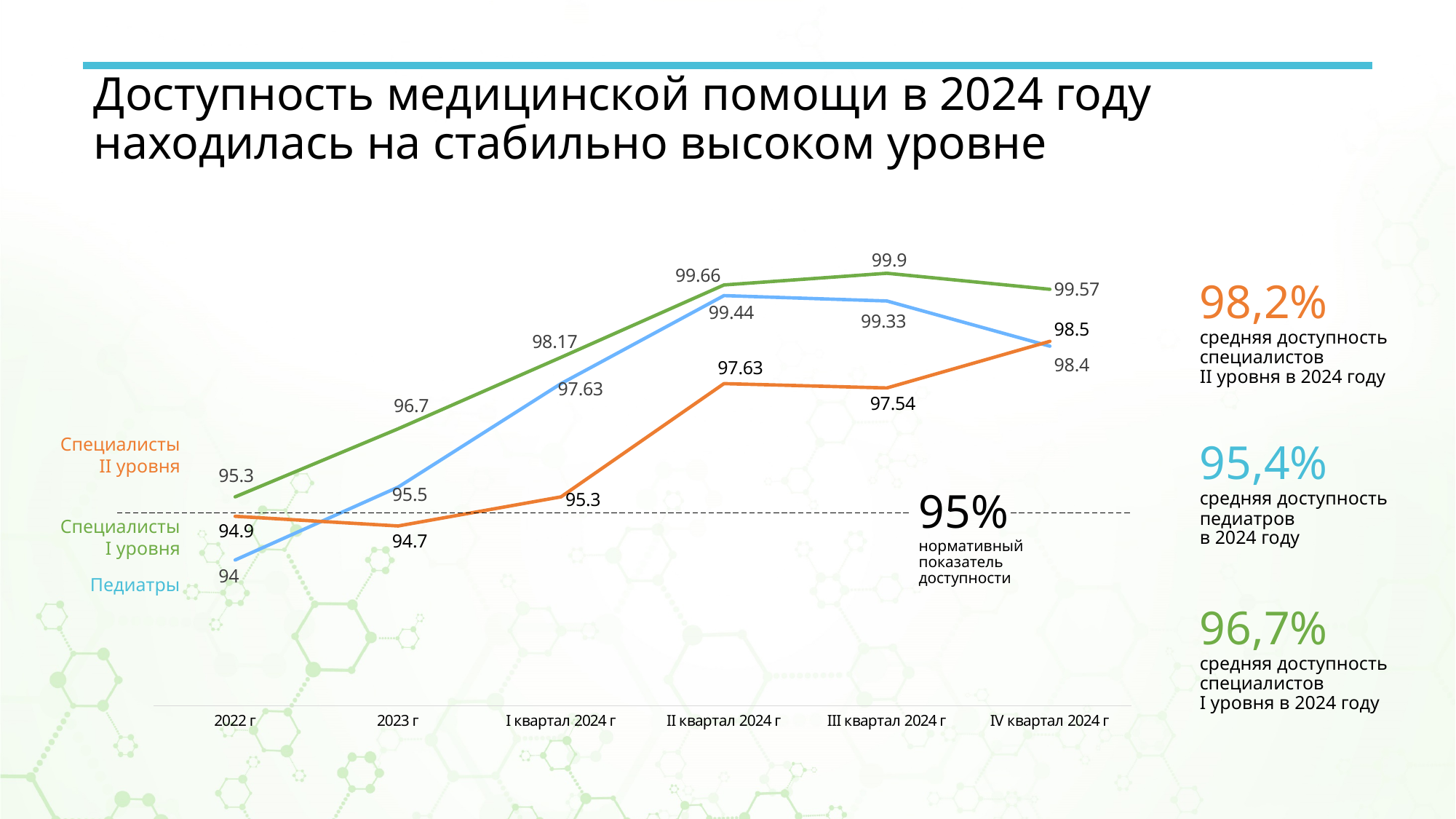
Does the value for Специалисты I уровня rise or fall from 2022 г to II квартал 2024 г? rise What is the value for Педиатры in 2022 г? 94 What is the value for Специалисты II уровня in 2023 г? 94.7 In which period is the value for Специалисты I уровня highest? III квартал 2024 г What is the value for Специалисты II уровня in IV квартал 2024 г? 98.5 Which is larger in 2023 г: the value for Педиатры or the value for Специалисты II уровня? Педиатры What kind of chart is shown on the slide? line chart How many series does the chart show? 3 How many points are on the x axis of the chart? 6 In which period is the value for Педиатры lowest? 2022 г What is the difference between the Специалисты I уровня value and the Специалисты II уровня value in II квартал 2024 г? 2.03 What is the value for Специалисты I уровня in III квартал 2024 г? 99.9